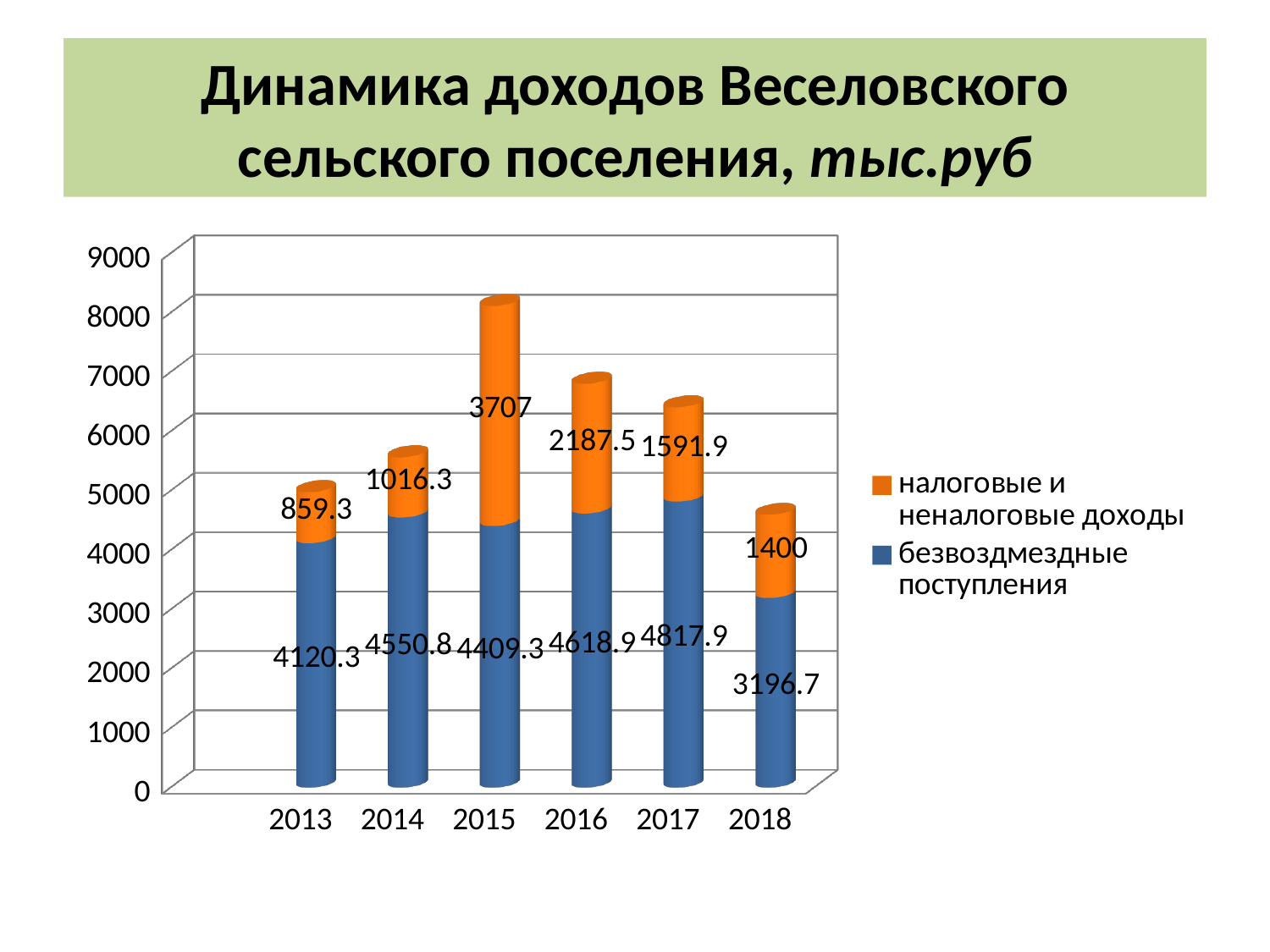
What is the value of налоговые и неналоговые доходы for 2018? 1400 What is the total height of the stacked bar for 2015? 8116.3 In which year is the value of безвозмездные поступления the lowest? 2018 What type of chart is shown on the slide? stacked bar chart Is the total of the stacked bar for 2013 greater or less than 5000? less Which is larger: налоговые и неналоговые доходы in 2016 or in 2017? 2016 What is the difference between безвозмездные поступления in 2017 and in 2018? 1621.2 In which year is the value of налоговые и неналоговые доходы the highest? 2015 How many years are shown on the x axis? 6 What is the value of безвозмездные поступления for 2017? 4817.9 How many series does the legend list? 2 What is the value of налоговые и неналоговые доходы for 2015? 3707